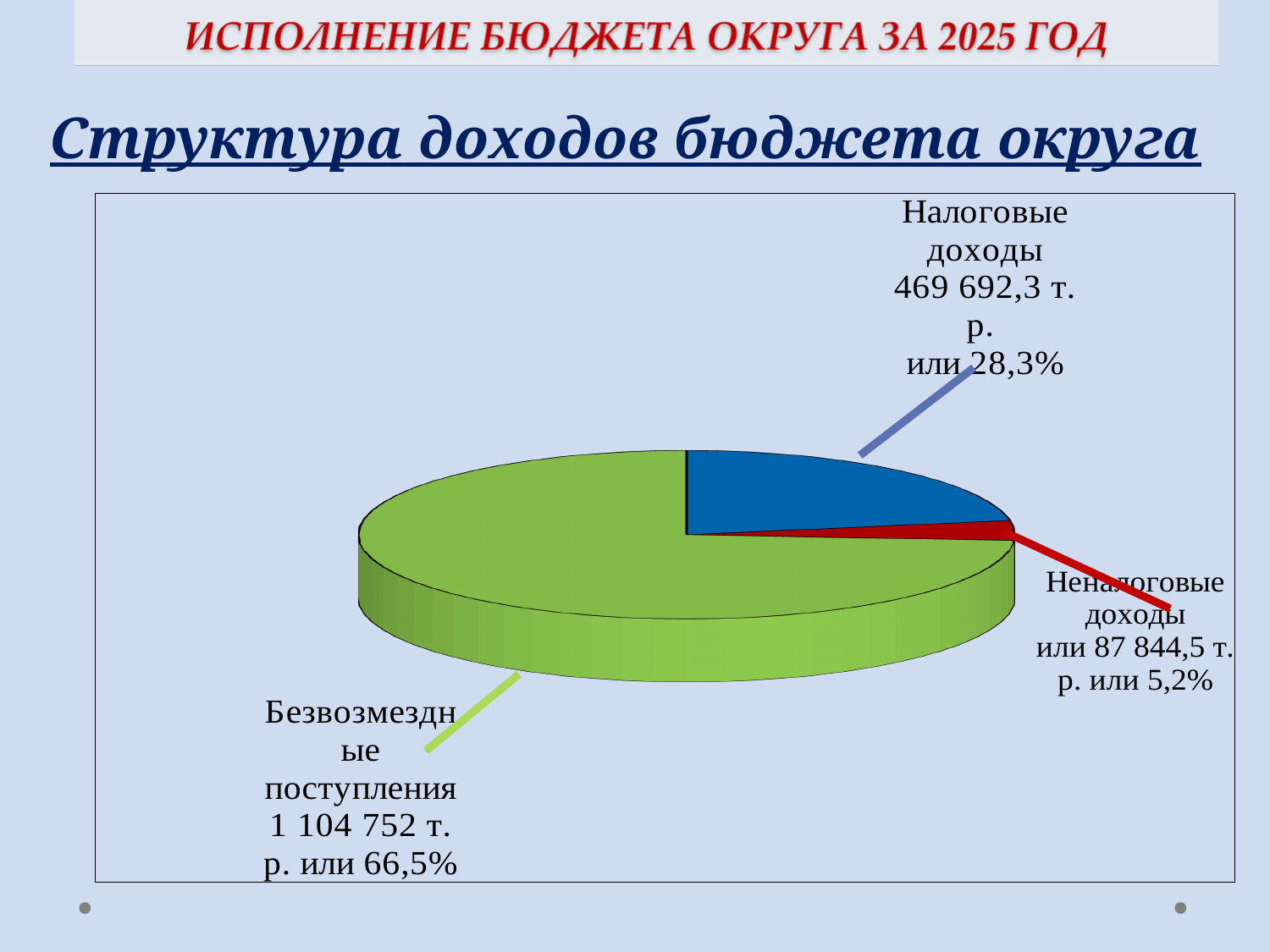
What share of the pie does Безвозмездные поступления represent? 66,5% What share of the pie does Неналоговые доходы represent? 5,2% What is the value shown for Неналоговые доходы in thousand roubles? 87 844,5 т. р. What is the value shown for Налоговые доходы in thousand roubles? 469 692,3 т. р. What is the difference in percentage points between the shares of Налоговые доходы and Неналоговые доходы? 23,1 What type of chart is shown on the slide? pie chart How many slices does the pie chart have? 3 What share of the pie does Налоговые доходы represent? 28,3% Which category has the smallest slice of the pie? Неналоговые доходы What is the value shown for Безвозмездные поступления in thousand roubles? 1 104 752 т. р. Which is larger, the share of Налоговые доходы or the share of Безвозмездные поступления? Безвозмездные поступления Which category has the largest slice of the pie? Безвозмездные поступления